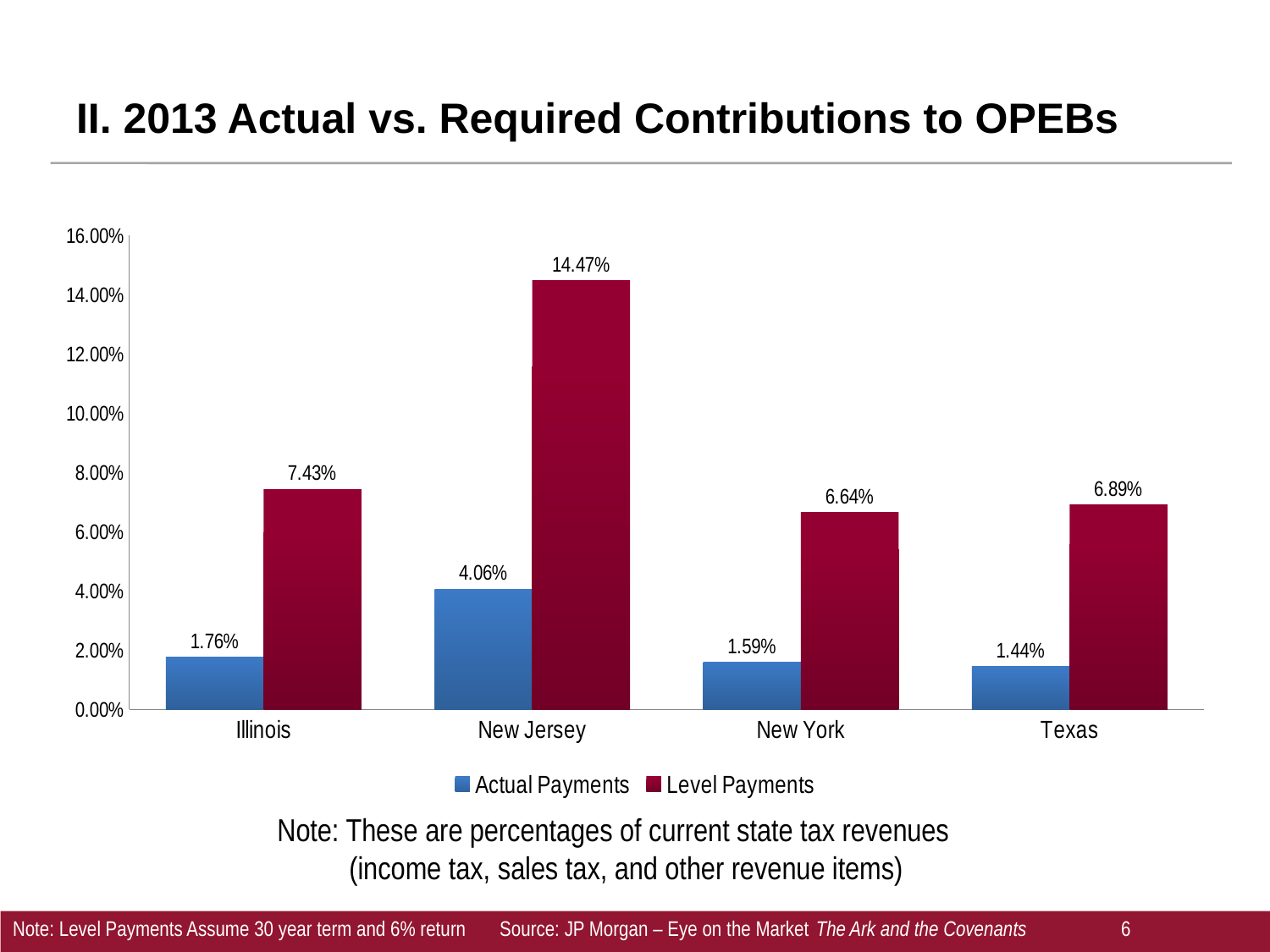
What is the Actual Payments value for New Jersey? 4.06% How many states are shown on the x axis? 4 Is the Level Payments value for New Jersey greater or less than 14.00%? greater What is the difference between Level Payments and Actual Payments for Illinois? 5.67% Which is larger, the Level Payments value for New York or for Texas? Texas Which colour represents Level Payments in the legend? Dark red How many series does the legend list? 2 What is the Level Payments value for Texas? 6.89% What kind of chart is shown on the slide? Bar chart Which state has the lowest Actual Payments value? Texas What is the Actual Payments value for New York? 1.59% Which state has the highest Level Payments value? New Jersey